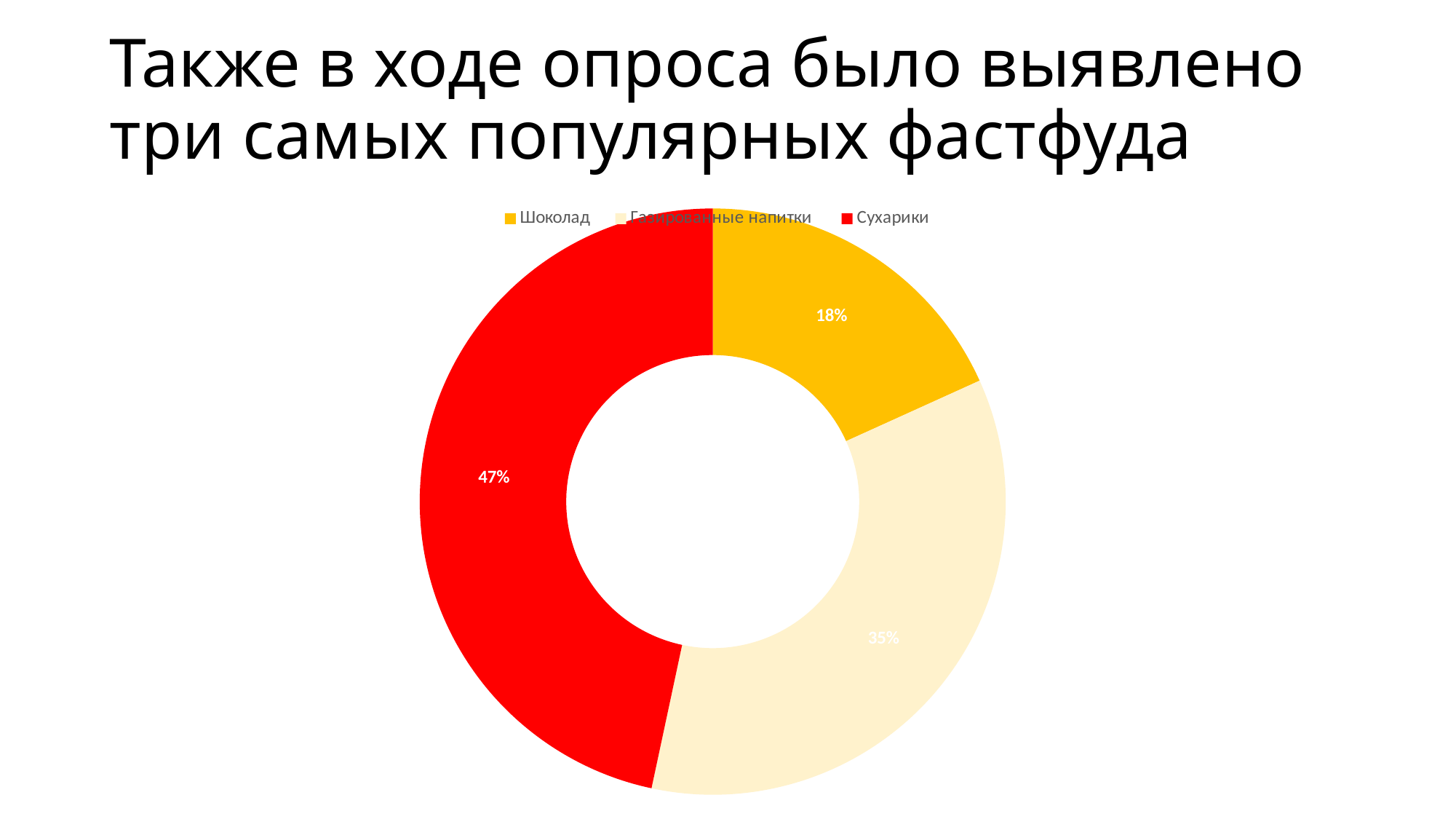
Which category has the smallest share of the chart? Шоколад What share of the chart does Газированные напитки account for? 35% What share of the chart does Сухарики account for? 47% What share of the chart does Шоколад account for? 18% What is the title of the slide? Также в ходе опроса было выявлено три самых популярных фастфуда What kind of chart is shown on the slide? Doughnut chart What is the difference in percentage points between Газированные напитки and Шоколад? 17 Which category has the largest share of the chart? Сухарики What is the difference in percentage points between Сухарики and Шоколад? 29 Which has a larger share, Газированные напитки or Шоколад? Газированные напитки How many categories are shown in the chart? 3 What colour is the Сухарики segment of the chart? Red